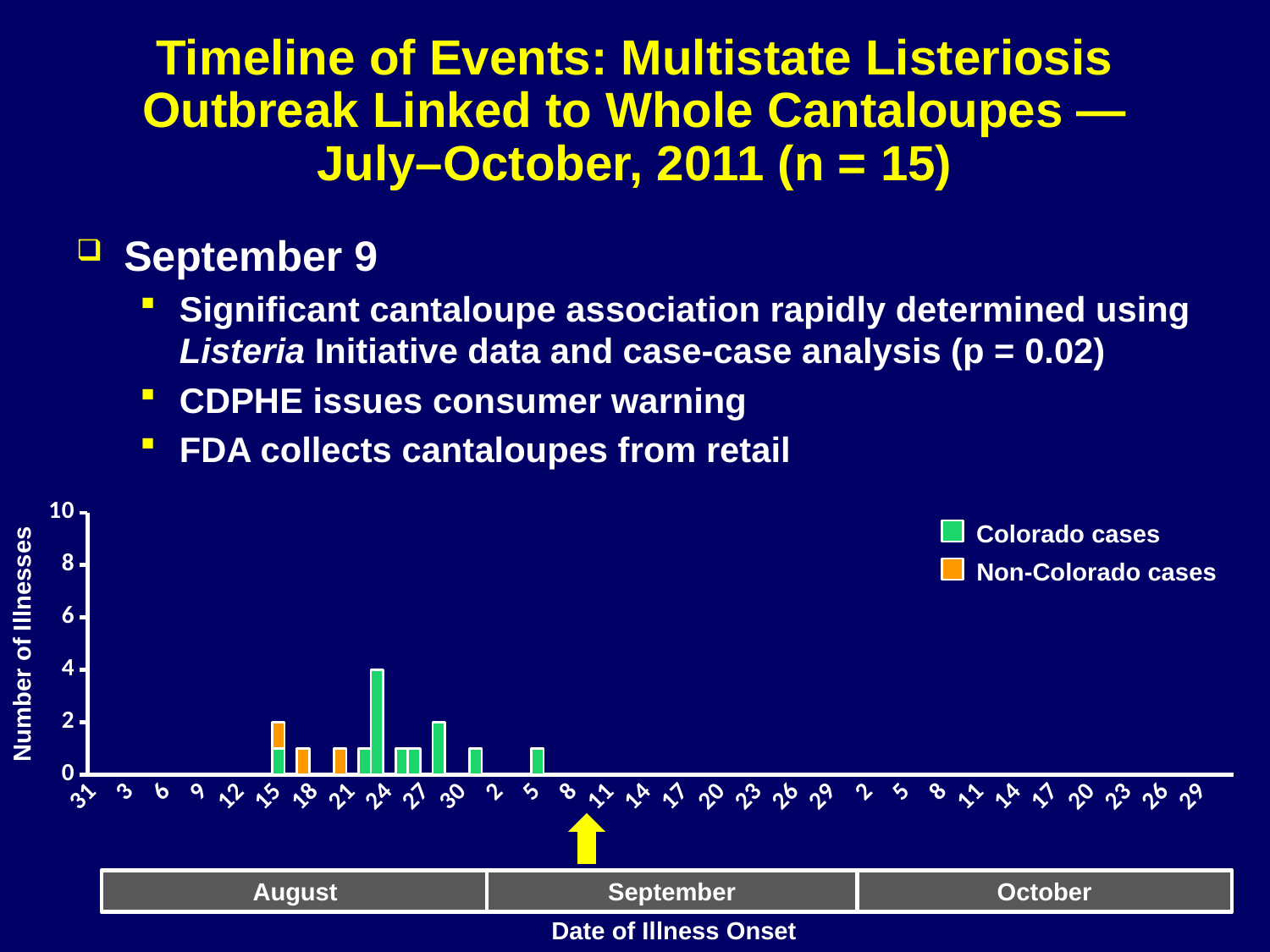
Is the number of illnesses for August 24 greater or less than 2? less What is the total number of illnesses shown for August 15? 2 Is the number of illnesses for September 5 greater or less than 2? less What is the title of the chart's vertical axis? Number of Illnesses Is the number of illnesses for August 24 greater or less than 6? less What are the two series named in the chart legend? Colorado cases and Non-Colorado cases How many series does the chart legend list? 2 On which date of illness onset does the chart show the highest number of illnesses? August 23 How many illnesses does the chart show for August 24? 0 What kind of chart is shown on the slide? bar chart